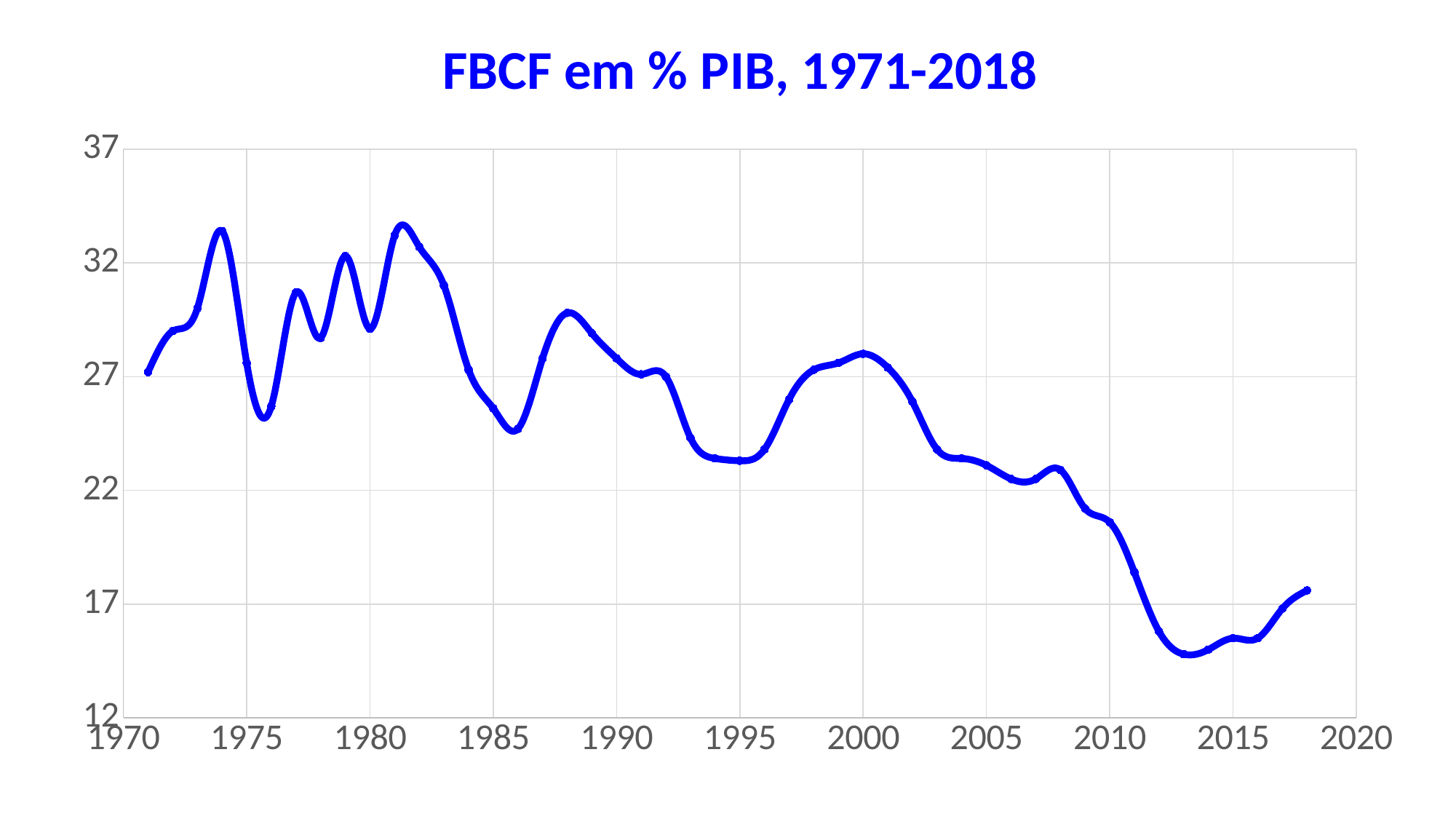
What is the title of the chart? FBCF em % PIB, 1971-2018 Is the value for 1985 greater or less than 27? less Which is larger, the value for 2000 or the value for 2010? 2000 Which year has the lowest value on the chart? 2013 Is the value for 2000 greater or less than 27? greater Is the value for 2015 greater or less than 17? less Which is larger, the value for 1980 or the value for 1990? 1980 Overall, do the values rise or fall from 1971 to 2018? fall What kind of chart is shown on the slide? line chart